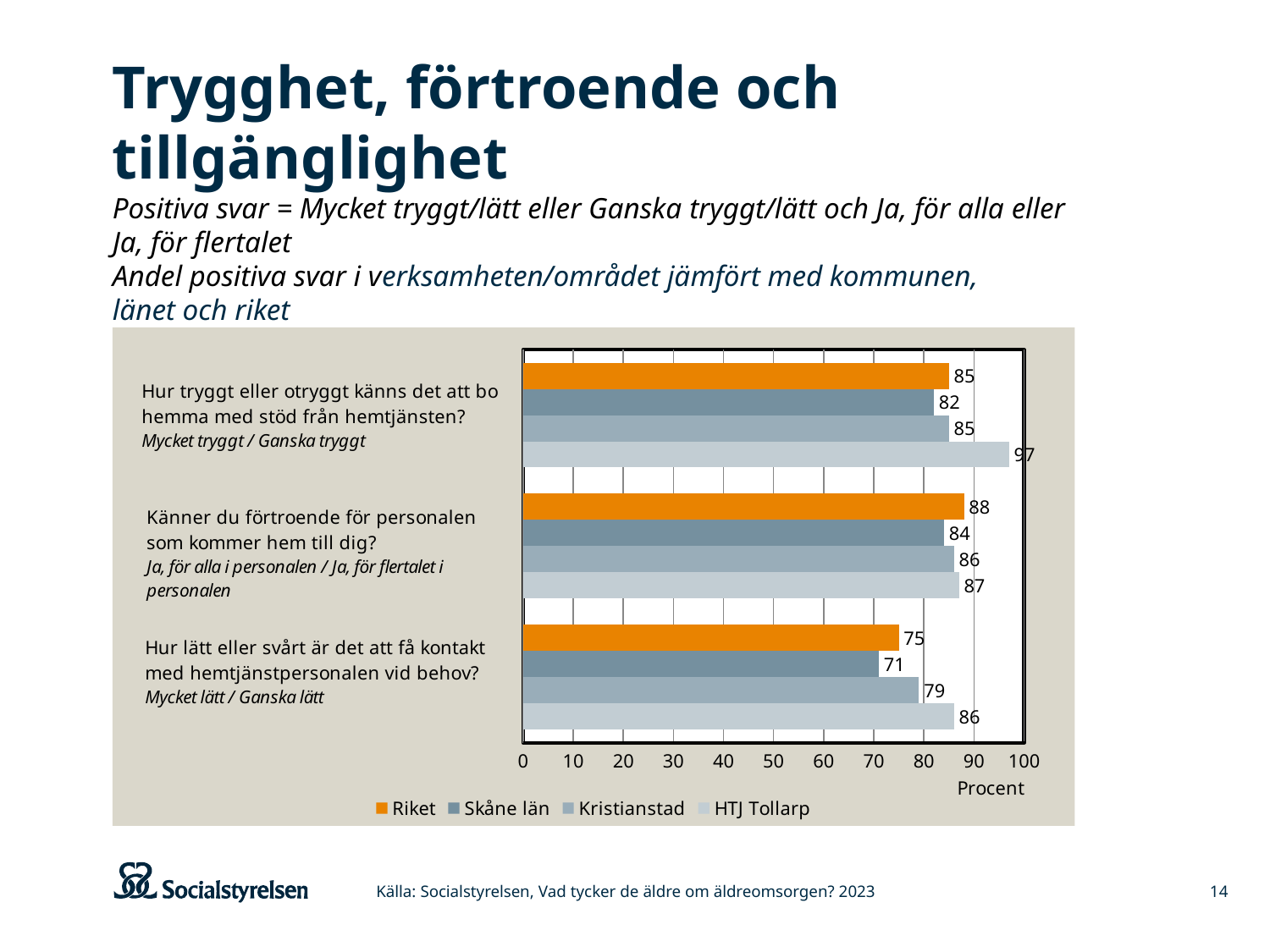
What kind of chart is shown on the slide? bar chart Which series has the lowest value on the question "Hur lätt eller svårt är det att få kontakt med hemtjänstpersonalen vid behov?"? Skåne län What is the value for Riket on the question "Känner du förtroende för personalen som kommer hem till dig?"? 88 What is the label of the x axis? Procent What is the value for HTJ Tollarp on the question "Hur tryggt eller otryggt känns det att bo hemma med stöd från hemtjänsten?"? 97 What is the difference between HTJ Tollarp and Riket on the question "Hur lätt eller svårt är det att få kontakt med hemtjänstpersonalen vid behov?"? 11 What is the value for Skåne län on the question "Hur lätt eller svårt är det att få kontakt med hemtjänstpersonalen vid behov?"? 71 How many question categories are plotted on the chart? 3 How many series does the legend list? 4 Which is larger on the question "Känner du förtroende för personalen som kommer hem till dig?": Riket or Skåne län? Riket Is the value for Skåne län on the question "Hur lätt eller svårt är det att få kontakt med hemtjänstpersonalen vid behov?" greater or less than 80? less Which series has the highest value on the question "Hur tryggt eller otryggt känns det att bo hemma med stöd från hemtjänsten?"? HTJ Tollarp